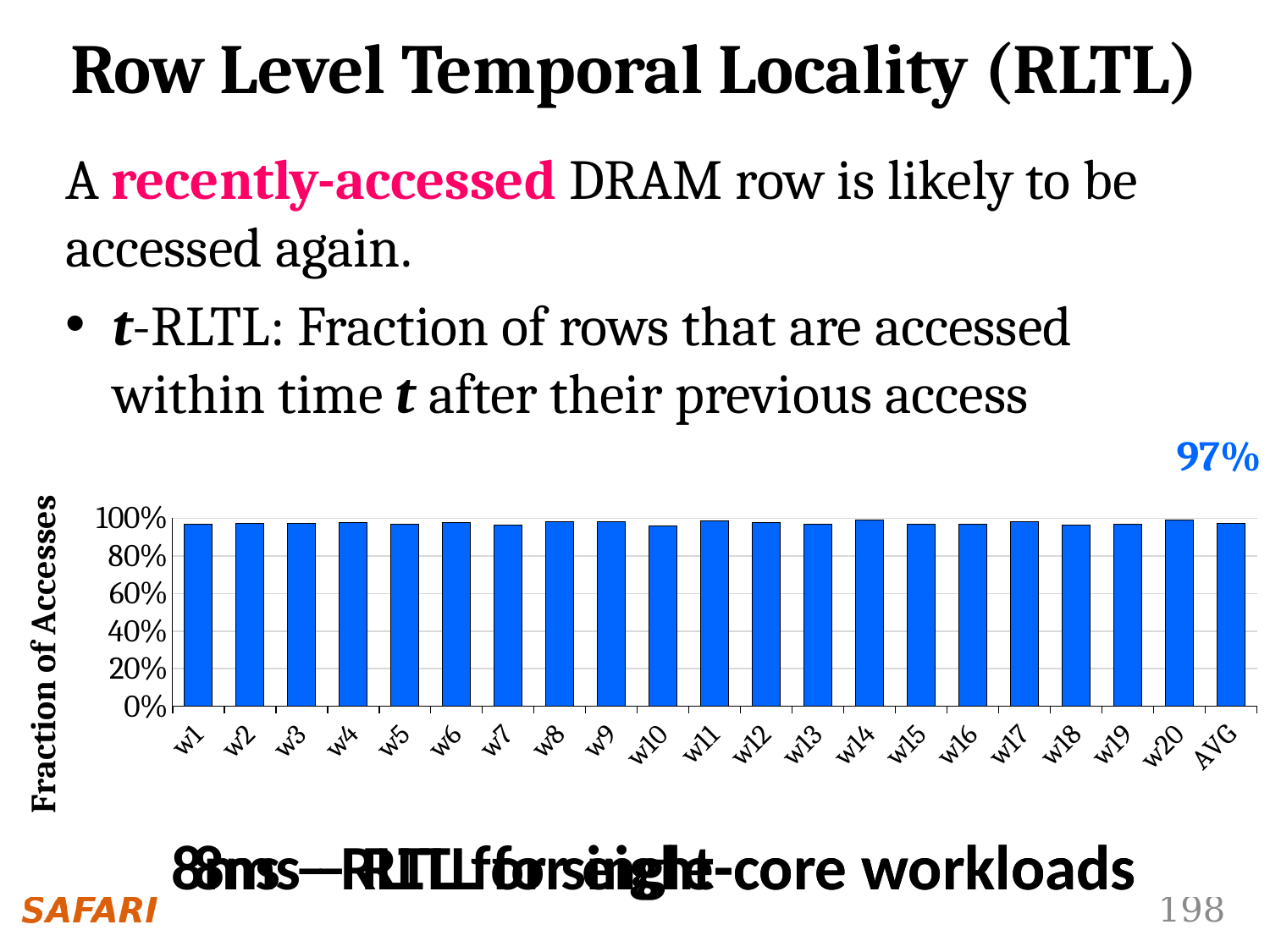
What is the label of the last category on the x axis of the chart? AVG Is the value for AVG greater or less than 20%? greater What value is labelled for the AVG bar in the chart? 97% Is the value for w20 greater or less than 40%? greater Do the bar values rise, fall, or stay roughly flat from w1 to w20? stay roughly flat How many categories are plotted along the x axis of the chart? 21 Is the value for w10 greater or less than 60%? greater What kind of chart is shown on the slide? bar chart What is the label of the y axis of the chart? Fraction of Accesses What is the highest tick value shown on the y axis of the chart? 100%